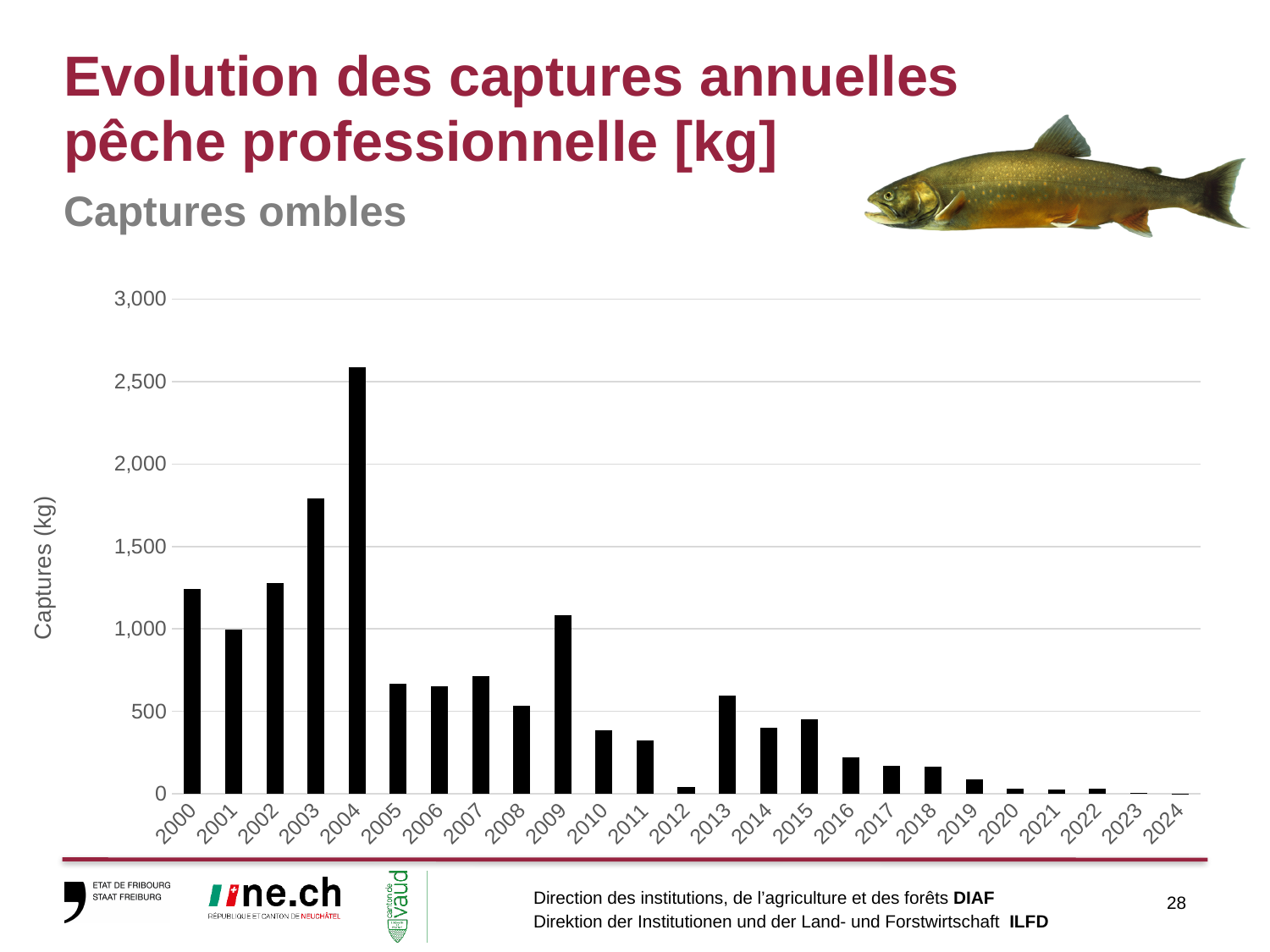
Is the value for 2004 greater or less than 2,500? greater What kind of chart is shown on the slide? bar chart Is the value for 2003 greater or less than 1,500? greater How many years are shown on the x axis of the chart? 25 Is the value for 2000 greater or less than 1,000? greater What is the label of the vertical axis of the chart? Captures (kg) Do the values generally rise or fall from 2004 to 2024? fall Which year has the larger value, 2009 or 2010? 2009 Which year has the larger value, 2002 or 2003? 2003 Which year has the highest catch value in the chart? 2004